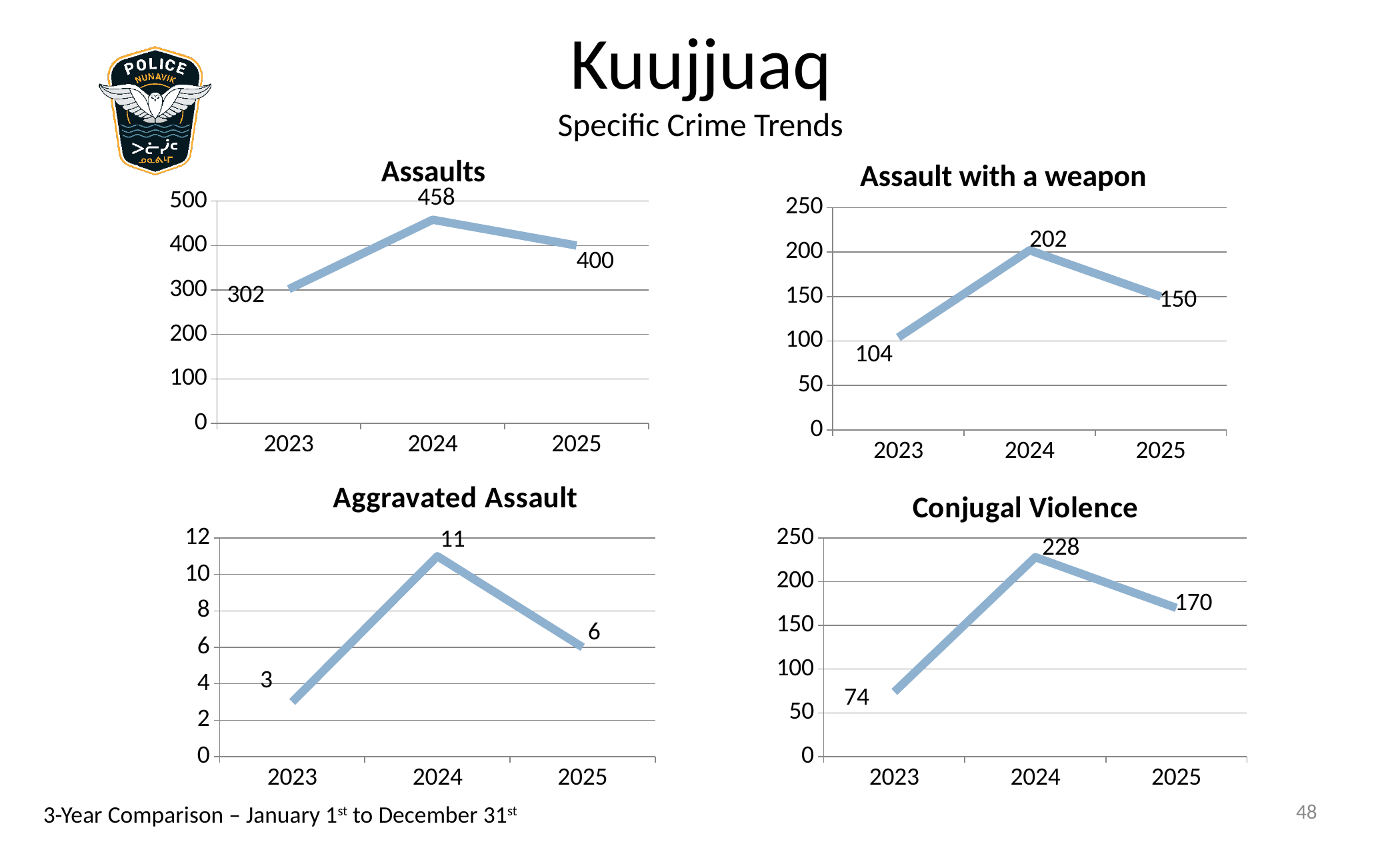
In the Assault with a weapon chart, what is the value for 2023? 104 In the Assault with a weapon chart, which is larger, the value for 2023 or the value for 2025? 2025 In the Assault with a weapon chart, does the value rise or fall from 2024 to 2025? Fall How many data points are plotted in the Conjugal Violence chart? 3 How many charts are shown on the slide? 4 In the Conjugal Violence chart, what is the value for 2025? 170 In the Aggravated Assault chart, what is the difference between the 2024 and 2023 values? 8 In the Conjugal Violence chart, which year has the lowest value? 2023 In the Assaults chart, what is the value for 2024? 458 In the Assaults chart, what is the difference between the 2024 and 2025 values? 58 What kind of chart is the Assaults chart? Line chart In the Aggravated Assault chart, which year has the highest value? 2024